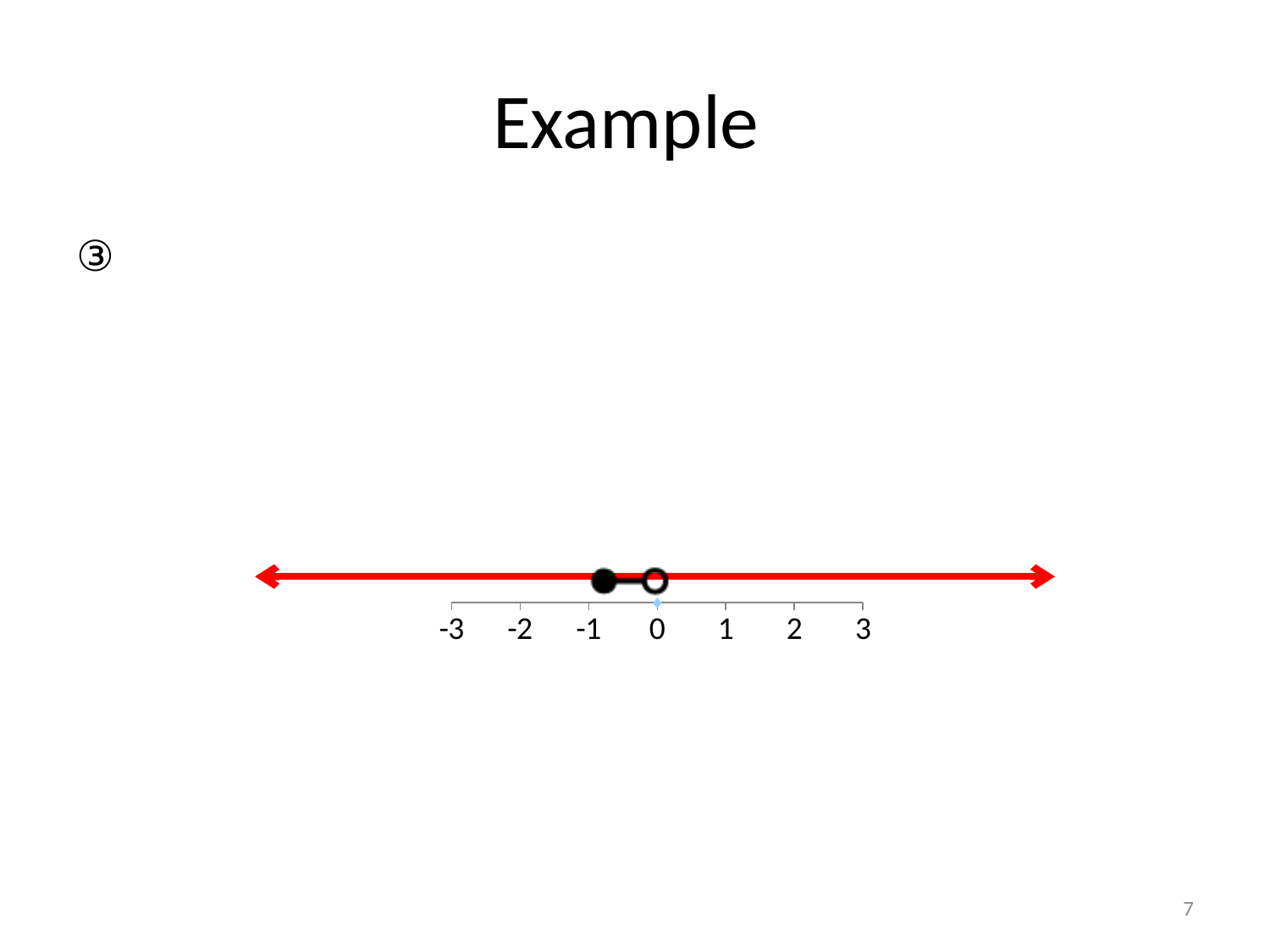
What is the largest value labeled on the number line axis? 3 At which labeled value on the number line is the open (hollow) circle located? 0 What is the smallest value labeled on the number line axis? -3 How many circle markers (filled or open) are drawn on the number line? 2 Which is located further to the right on the number line, the filled dot or the open circle? the open circle Is the filled black dot on the number line located at a value greater or less than 0? less Is the filled black dot on the number line located at a value greater or less than -1? greater How many numbered tick labels are shown on the number line axis? 7 What colour is the long double-arrowed line drawn across the number line? red What is the title of the slide containing the number line? Example